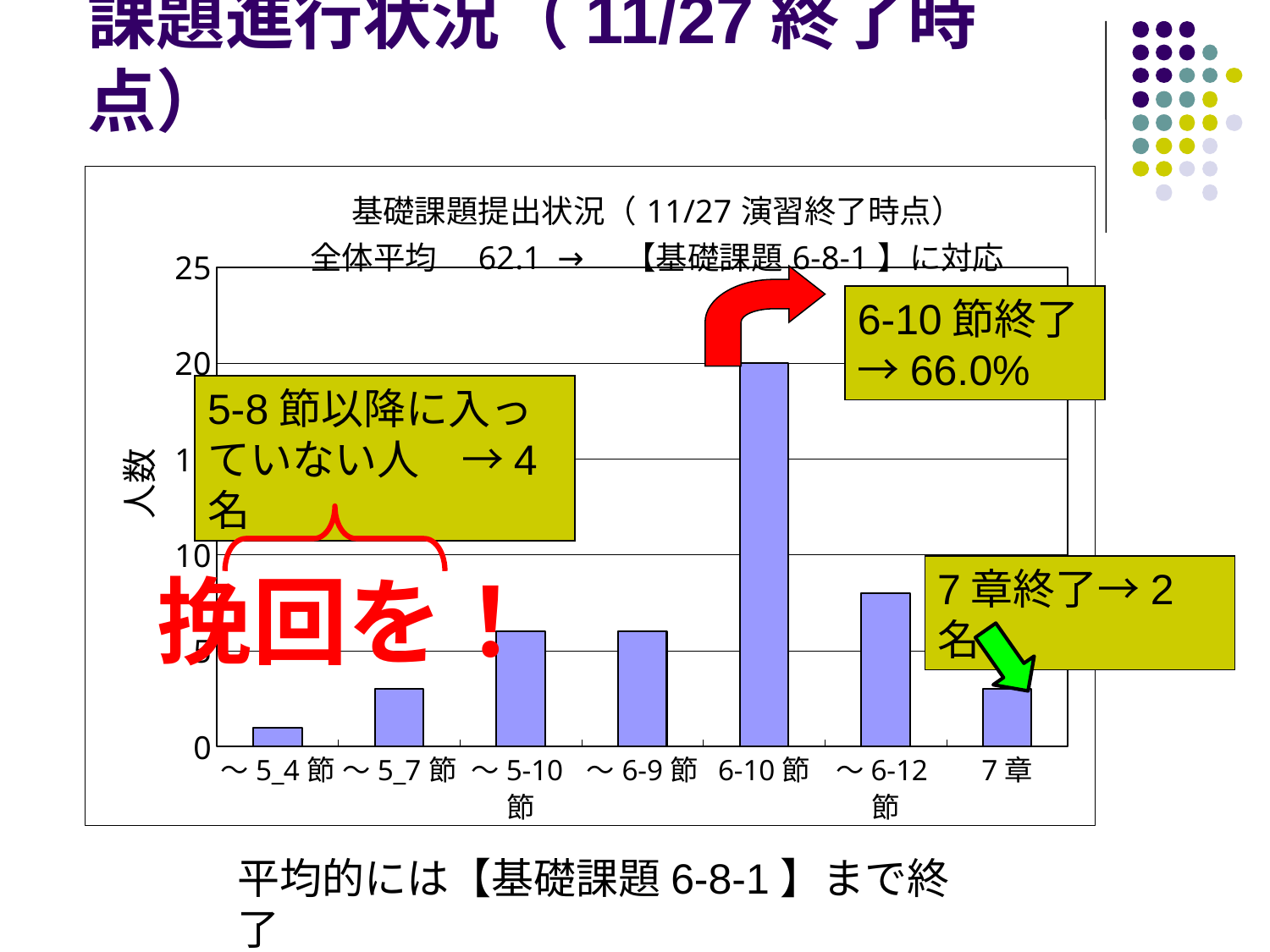
How many categories are plotted along the x axis of the chart? 7 Is the value for ～6-12 節 greater or less than 10? less What is the value for 6-10 節 in the chart? 20 Which is larger, the value for ～5_7 節 or the value for ～5_4 節? ～5_7 節 What is the label of the y axis of the chart? 人数 What kind of chart is shown on the slide? bar chart Which is larger, the value for 6-10 節 or the value for ～6-12 節? 6-10 節 Which category has the lowest value in the chart? ～5_4 節 Is the value for 6-10 節 greater or less than 15? greater Which category has the highest value in the chart? 6-10 節 Is the value for ～6-12 節 greater or less than 5? greater